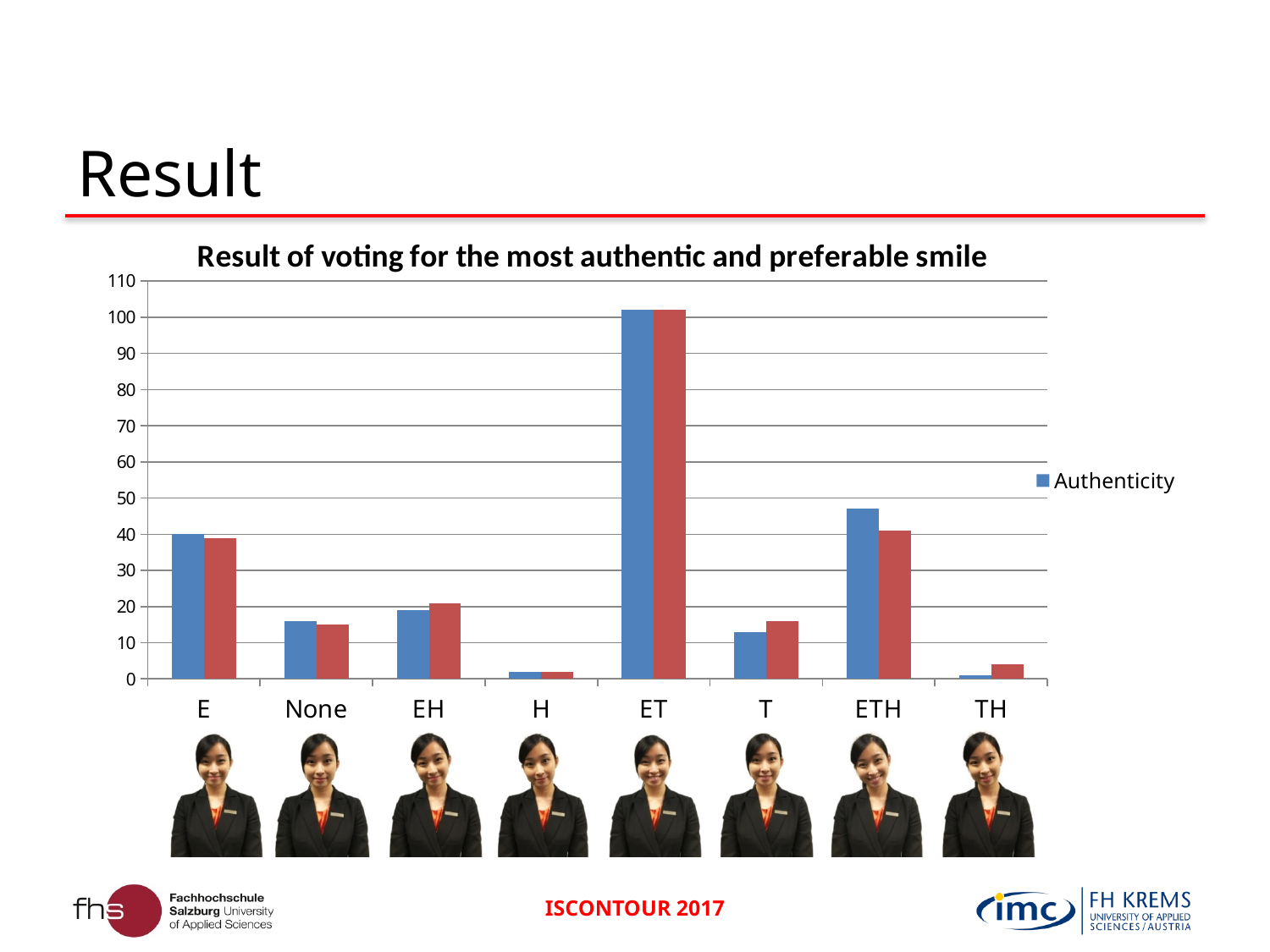
Is the Authenticity value for ETH greater or less than 40? greater How many series does the chart's legend list? 1 Which has the larger Authenticity value, ETH or EH? ETH Is the Authenticity value for E greater or less than 50? less Is the Authenticity value for ET greater or less than 90? greater What kind of chart is shown on the slide? bar chart What series name is shown in the chart's legend? Authenticity How many categories are shown on the x axis of the chart? 8 What is the title of the chart? Result of voting for the most authentic and preferable smile Which has the larger Authenticity value, E or None? E Which category has the highest Authenticity value? ET